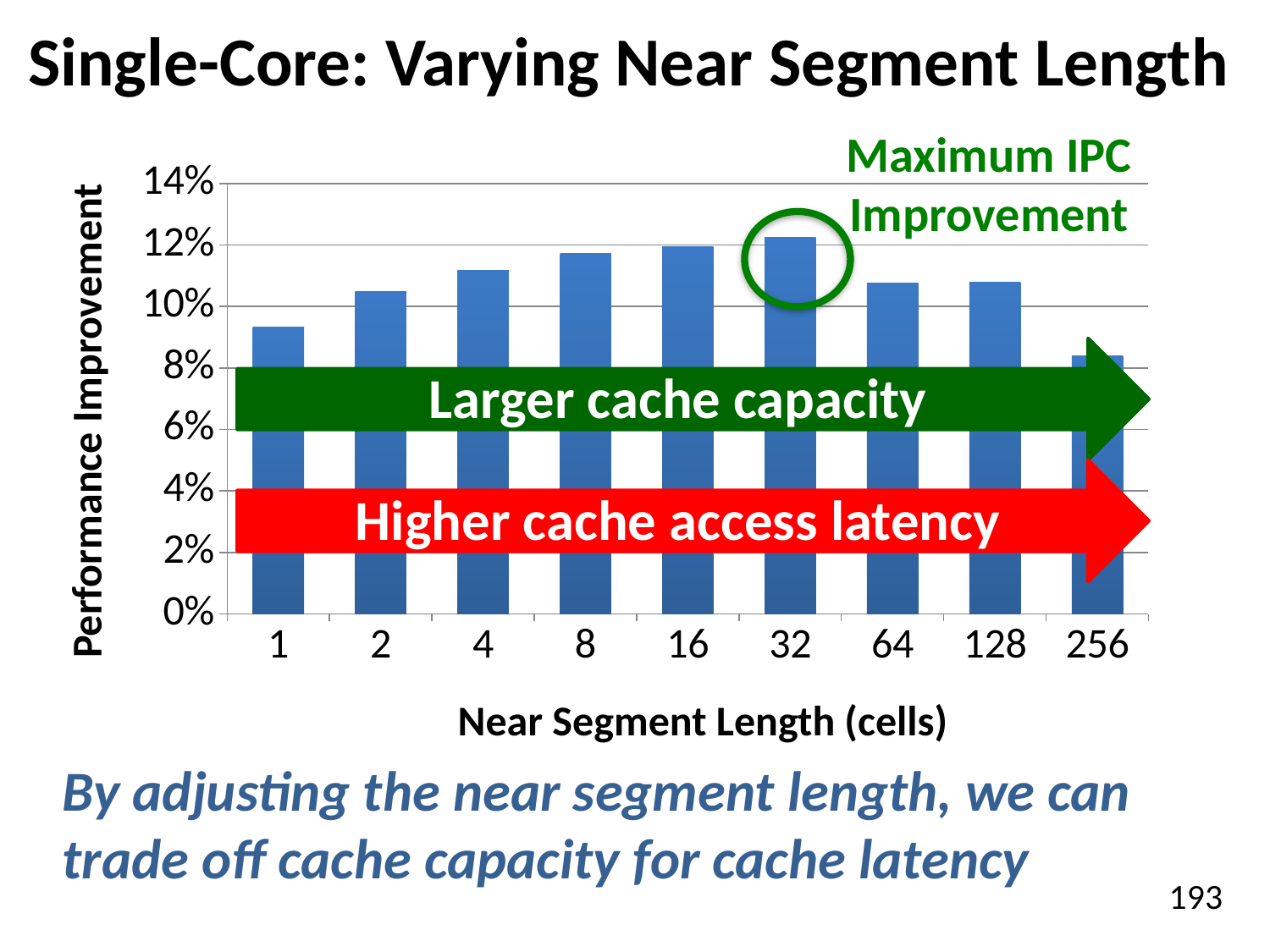
What kind of chart is shown on the slide? bar chart Is the performance improvement for a near segment length of 8 greater or less than 12%? less Which has the larger performance improvement: a near segment length of 16 or 256? 16 Which near segment length gives the lowest performance improvement? 256 What is the label of the x axis? Near Segment Length (cells) Which near segment length gives the highest performance improvement? 32 Which has the larger performance improvement: a near segment length of 1 or 2? 2 How many near segment lengths are plotted on the x axis? 9 Is the performance improvement for a near segment length of 1 greater or less than 8%? greater Is the performance improvement for a near segment length of 64 greater or less than 10%? greater How does the performance improvement change as the near segment length increases from 1 to 256? It rises up to 32, then falls